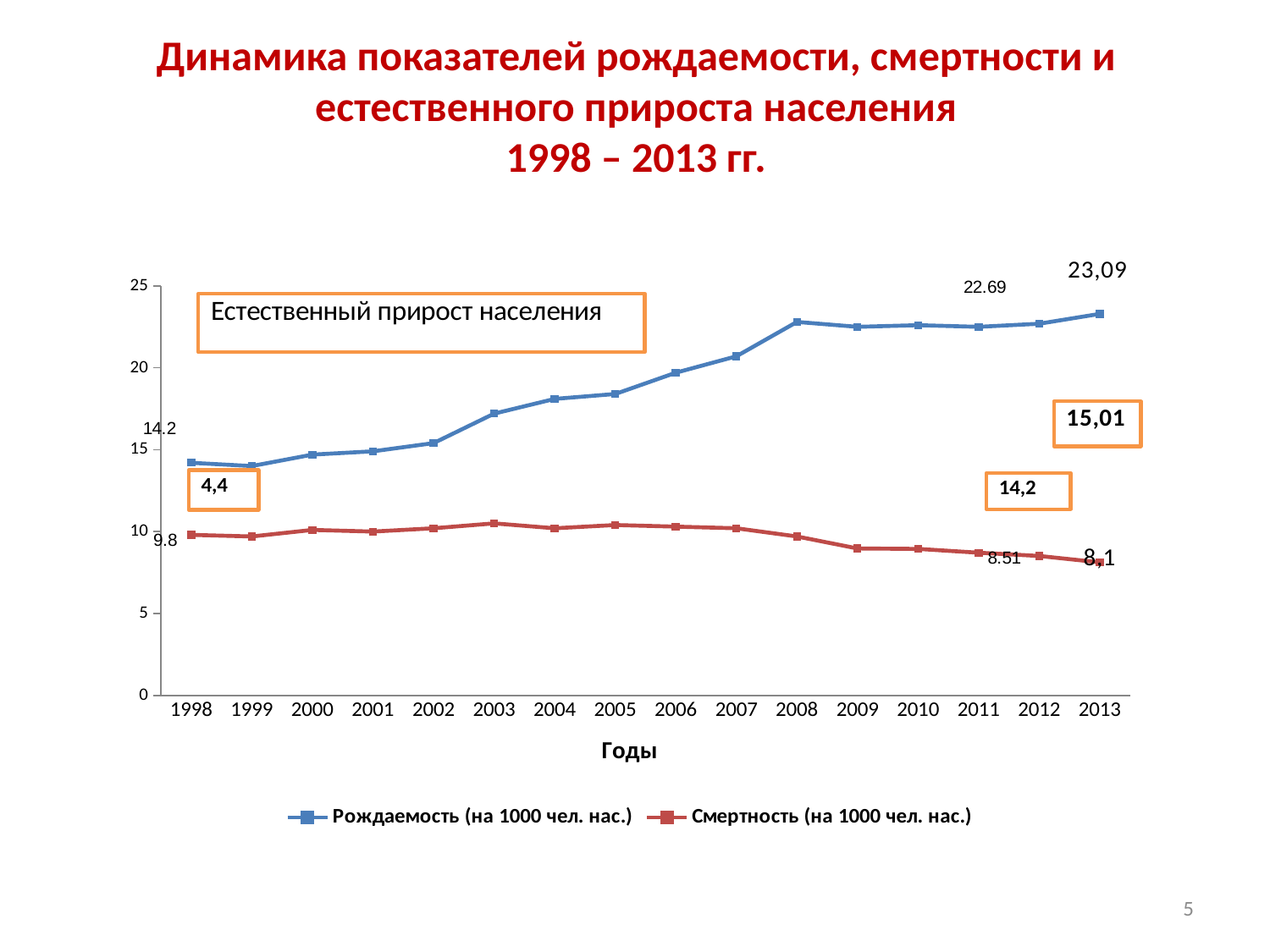
What is the value of Рождаемость (на 1000 чел. нас.) in 1998? 14.2 What kind of chart is shown on the slide? line chart What is the value of Рождаемость (на 1000 чел. нас.) in 2013? 23,09 What is the value of Смертность (на 1000 чел. нас.) in 1998? 9.8 How many series does the legend list? 2 What is the difference between Рождаемость and Смертность in 1998? 4.4 Is the value of Рождаемость (на 1000 чел. нас.) in 2008 greater or less than 20? greater Does Рождаемость (на 1000 чел. нас.) generally rise or fall from 1998 to 2013? rise How many years are shown on the x axis? 16 In which year is Смертность (на 1000 чел. нас.) lowest? 2013 Which series has the larger value in 2013, Рождаемость or Смертность? Рождаемость (на 1000 чел. нас.)